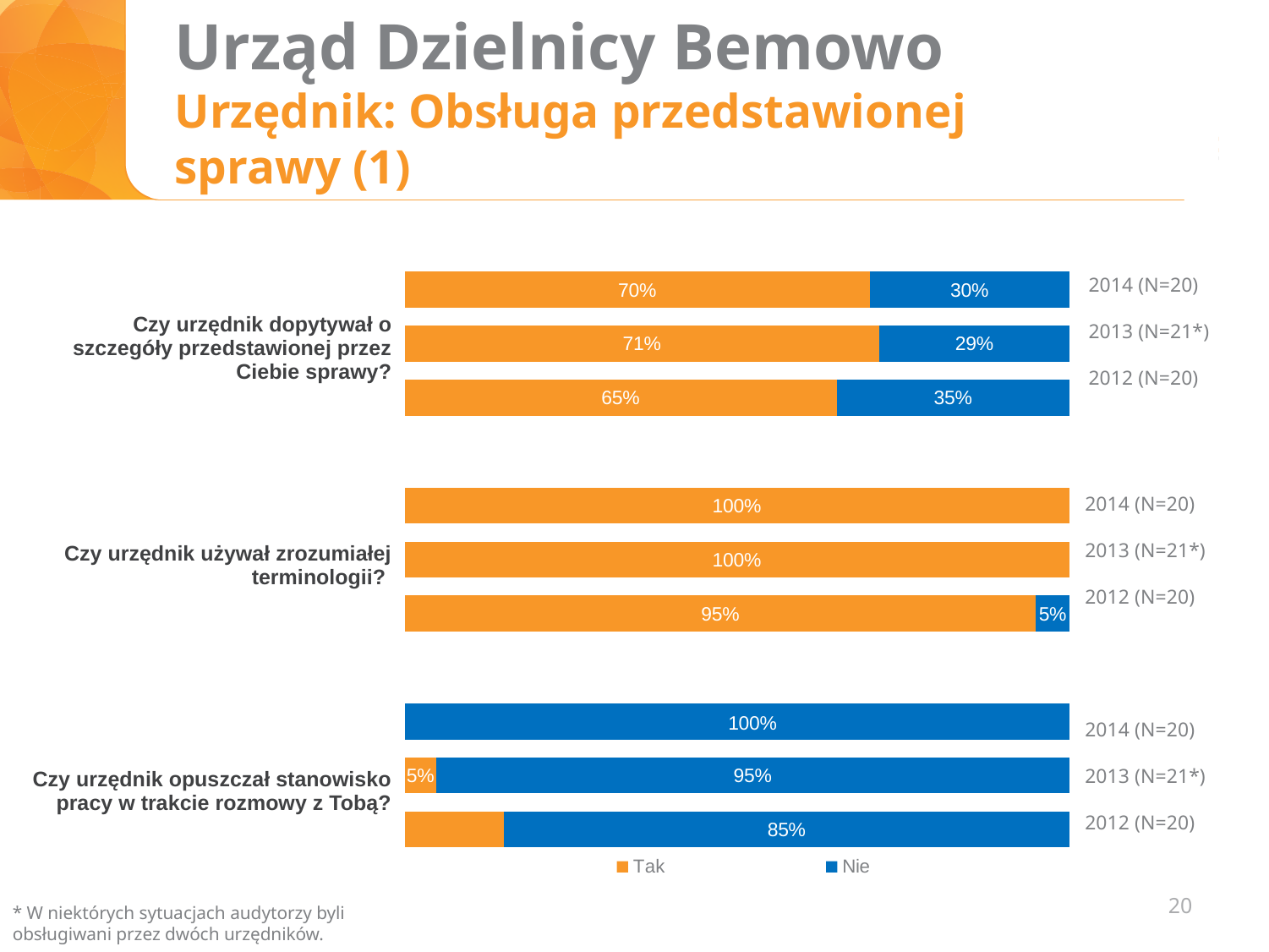
What percentage answered "Nie" in 2012 for "Czy urzędnik używał zrozumiałej terminologii?"? 5% For "Czy urzędnik dopytywał o szczegóły przedstawionej przez Ciebie sprawy?", which year had the highest "Tak" share? 2013 What percentage answered "Tak" in 2013 for "Czy urzędnik opuszczał stanowisko pracy w trakcie rozmowy z Tobą?"? 5% For "Czy urzędnik dopytywał o szczegóły przedstawionej przez Ciebie sprawy?", what is the difference between the "Tak" share in 2013 and in 2012? 6 percentage points What kind of chart is shown on the slide? Stacked bar chart What are the two legend entries of the chart? Tak and Nie For "Czy urzędnik dopytywał o szczegóły przedstawionej przez Ciebie sprawy?", which year had the higher "Tak" share, 2014 or 2012? 2014 What percentage answered "Tak" in 2014 for "Czy urzędnik dopytywał o szczegóły przedstawionej przez Ciebie sprawy?"? 70% What percentage answered "Nie" in 2012 for "Czy urzędnik opuszczał stanowisko pracy w trakcie rozmowy z Tobą?"? 85% What percentage answered "Nie" in 2012 for "Czy urzędnik dopytywał o szczegóły przedstawionej przez Ciebie sprawy?"? 35% How many series does the legend list? 2 What percentage answered "Nie" in 2014 for "Czy urzędnik opuszczał stanowisko pracy w trakcie rozmowy z Tobą?"? 100%